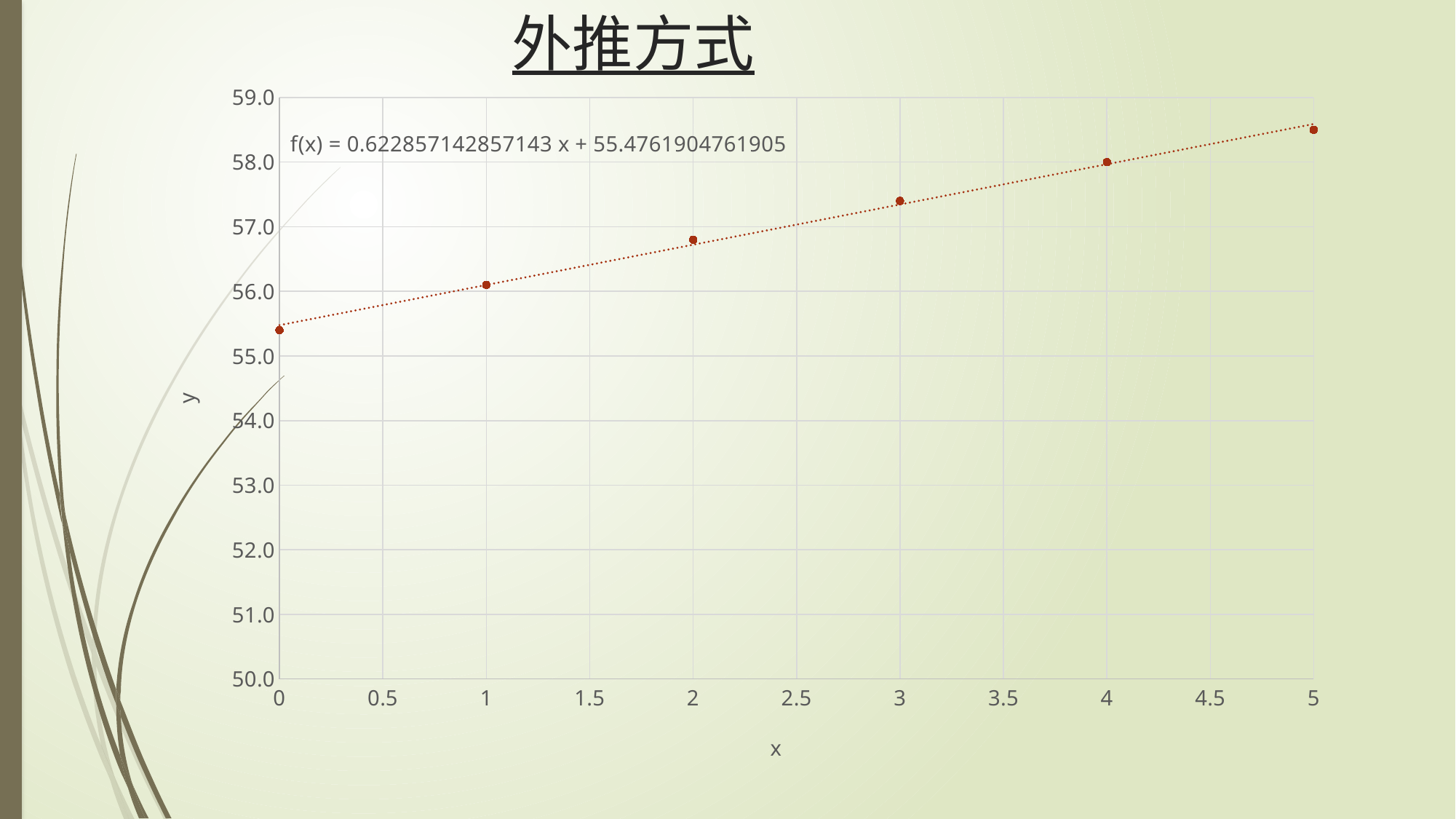
What kind of chart is shown on the slide? scatter chart At which x value is the plotted y value lowest? 0 Do the y values rise or fall as x increases along the x axis? rise At which x value is the plotted y value highest? 5 Is the y value at x = 0 greater or less than 55.0? greater Is the y value at x = 2 greater or less than 57.0? less Is the y value at x = 5 greater or less than 58.0? greater Which has the larger y value, the point at x = 3 or the point at x = 1? x = 3 What is the title of the slide? 外推方式 How many data points are plotted on the chart? 6 What is the trendline equation printed on the chart? f(x) = 0.622857142857143 x + 55.4761904761905